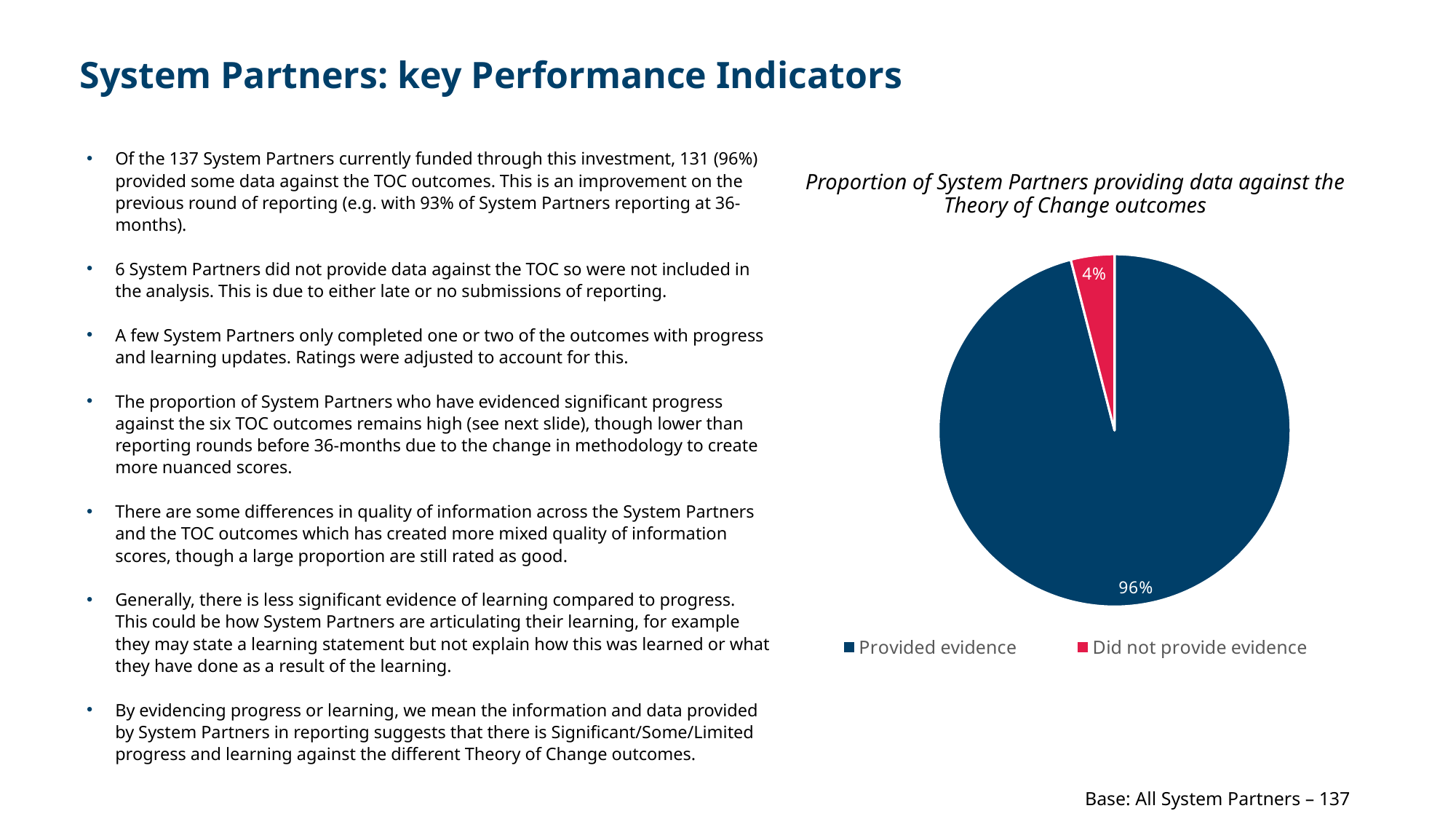
What kind of chart is shown on the slide? Pie chart What percentage of System Partners provided evidence? 96% What colour is the 'Did not provide evidence' slice? Red Which is larger: the share for 'Provided evidence' or 'Did not provide evidence'? Provided evidence What is the title of the pie chart? Proportion of System Partners providing data against the Theory of Change outcomes What percentage of System Partners did not provide evidence? 4% What is the difference in percentage points between 'Provided evidence' and 'Did not provide evidence'? 92 What share of the pie does the 'Did not provide evidence' slice represent? 4% How many entries does the legend list? 2 Which category has the largest share of the pie? Provided evidence How many slices does the pie chart have? 2 Which category has the smallest share of the pie? Did not provide evidence